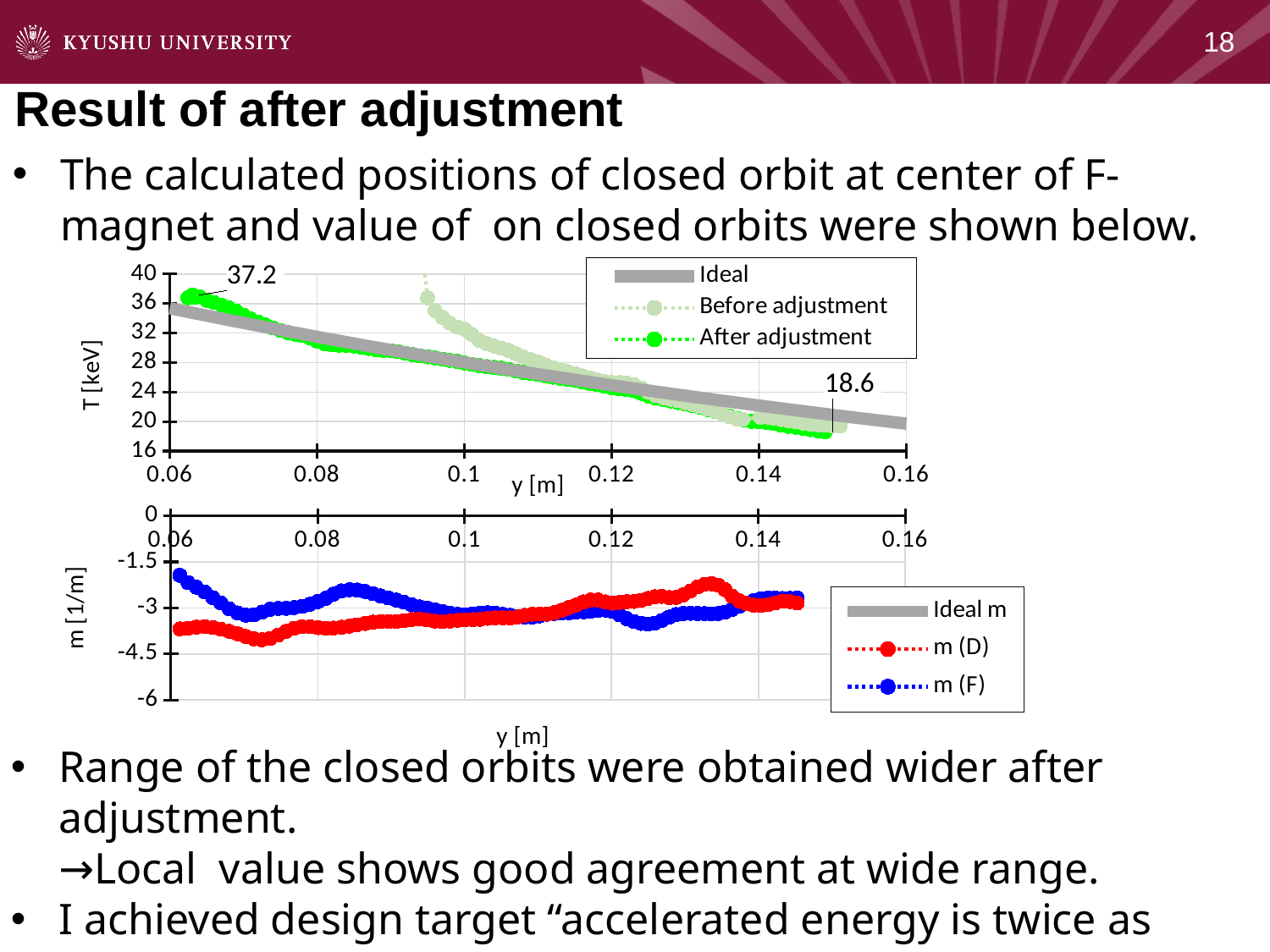
In the bottom chart (m [1/m] vs y [m]), is the m (D) value at y = 0.07 greater or less than -3? less In the top chart (T [keV] vs y [m]), what is the labelled maximum value of the After adjustment series? 37.2 In the bottom chart (m [1/m] vs y [m]), which series has the larger value at y = 0.07, m (D) or m (F)? m (F) In the top chart (T [keV] vs y [m]), what is the labelled minimum value of the After adjustment series? 18.6 How many series does the legend of the top chart (T [keV] vs y [m]) list? 3 In the top chart (T [keV] vs y [m]), what is the difference between the two labelled values 37.2 and 18.6? 18.6 In the bottom chart (m [1/m] vs y [m]), is the m (F) value at y = 0.06 greater or less than -3? greater In the top chart (T [keV] vs y [m]), does T rise or fall as y increases along the x axis? fall What are the legend entries of the bottom chart (m [1/m] vs y [m])? Ideal m, m (D), m (F) In the top chart (T [keV] vs y [m]), is the After adjustment value at y = 0.1 greater or less than 32? less How many series does the legend of the bottom chart (m [1/m] vs y [m]) list? 3